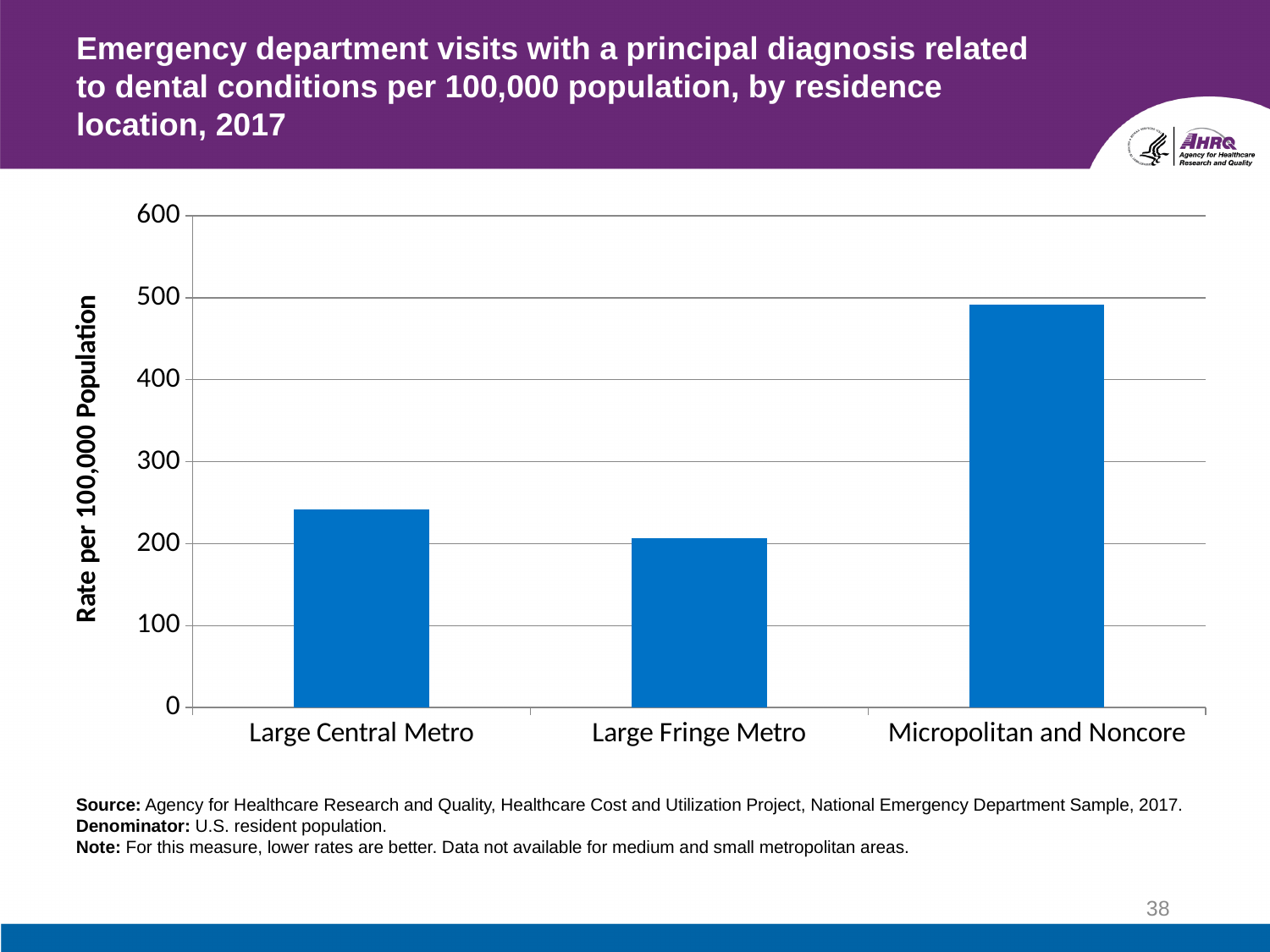
How many residence location categories are shown on the x axis? 3 What is the maximum value shown on the y axis? 600 Which residence location has the lowest rate of emergency department visits for dental conditions? Large Fringe Metro What type of chart is shown on the slide? bar chart Which has a higher rate, Large Central Metro or Large Fringe Metro? Large Central Metro Is the value for Micropolitan and Noncore greater or less than 400? greater What is the label of the y axis? Rate per 100,000 Population Is the value for Large Fringe Metro greater or less than 300? less Is the value for Large Central Metro greater or less than 300? less Which has a higher rate, Large Fringe Metro or Micropolitan and Noncore? Micropolitan and Noncore Which residence location has the highest rate of emergency department visits for dental conditions? Micropolitan and Noncore